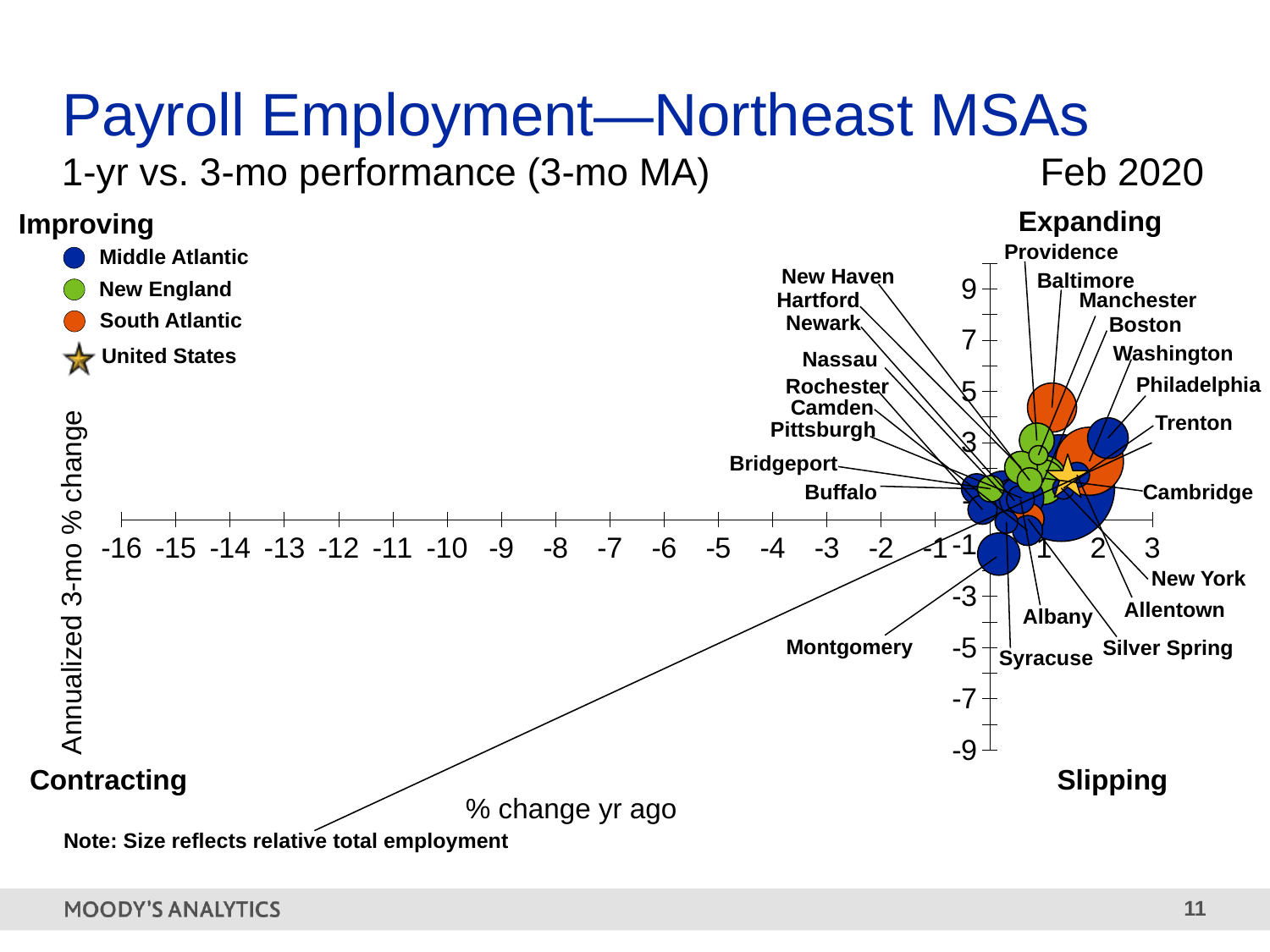
Is the annualized 3-mo % change for Trenton greater or less than 1? greater How many entries does the legend list? 4 What kind of chart is shown on the slide? Bubble chart What is the label of the vertical axis? Annualized 3-mo % change Is the annualized 3-mo % change for Montgomery greater or less than 0? less Is the % change yr ago for Trenton greater or less than 0? greater Which legend entry is represented by a star marker? United States